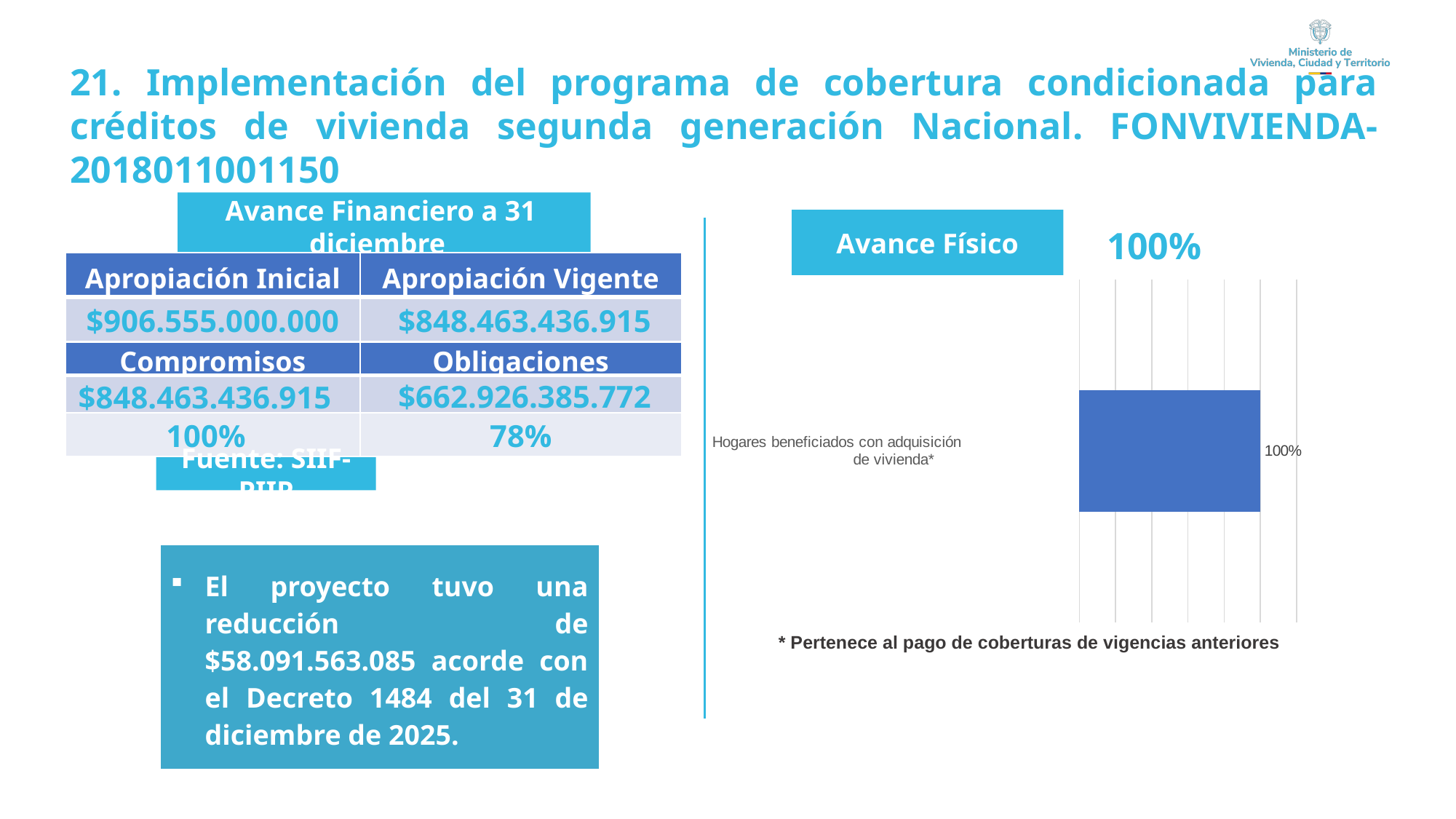
What is the label of the single category in the Avance Físico chart? Hogares beneficiados con adquisición de vivienda* What kind of chart is shown under 'Avance Físico'? Bar chart How many categories are plotted in the Avance Físico chart? 1 Is the bar in the Avance Físico chart oriented horizontally or vertically? Horizontally What value is shown for 'Hogares beneficiados con adquisición de vivienda*' in the Avance Físico chart? 100%